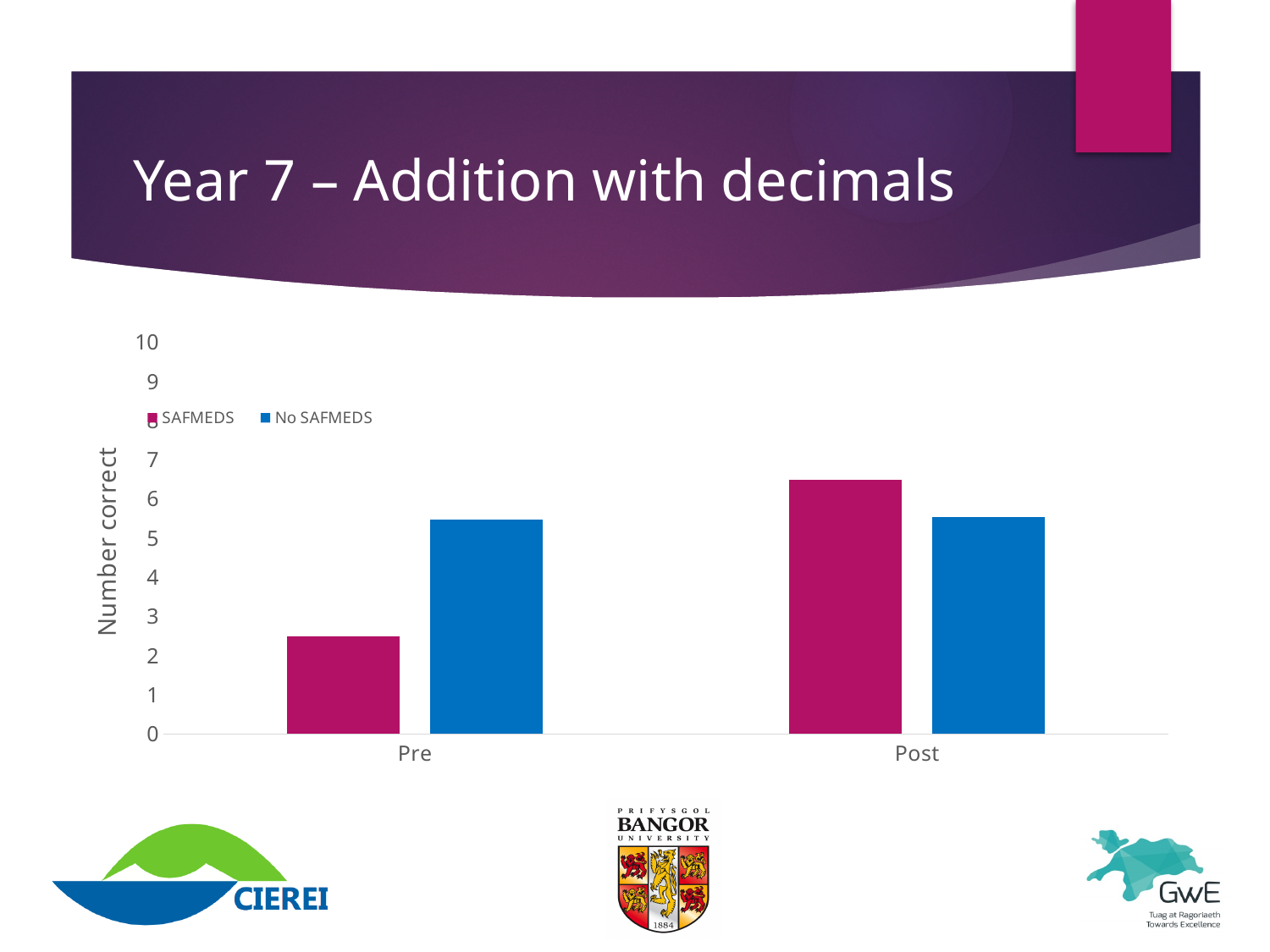
What kind of chart is shown on the slide? bar chart Which bar is the tallest in the chart? SAFMEDS at Post What is the label on the y axis of the chart? Number correct At Pre, which series has the larger value, SAFMEDS or No SAFMEDS? No SAFMEDS Is the value for SAFMEDS at Post greater or less than 6? greater How many series does the legend list? 2 Is the value for No SAFMEDS at Pre greater or less than 5? greater Is the value for No SAFMEDS at Post greater or less than 6? less At Post, which series has the larger value, SAFMEDS or No SAFMEDS? SAFMEDS Does the SAFMEDS value rise or fall from Pre to Post? rise How many categories are shown on the x axis? 2